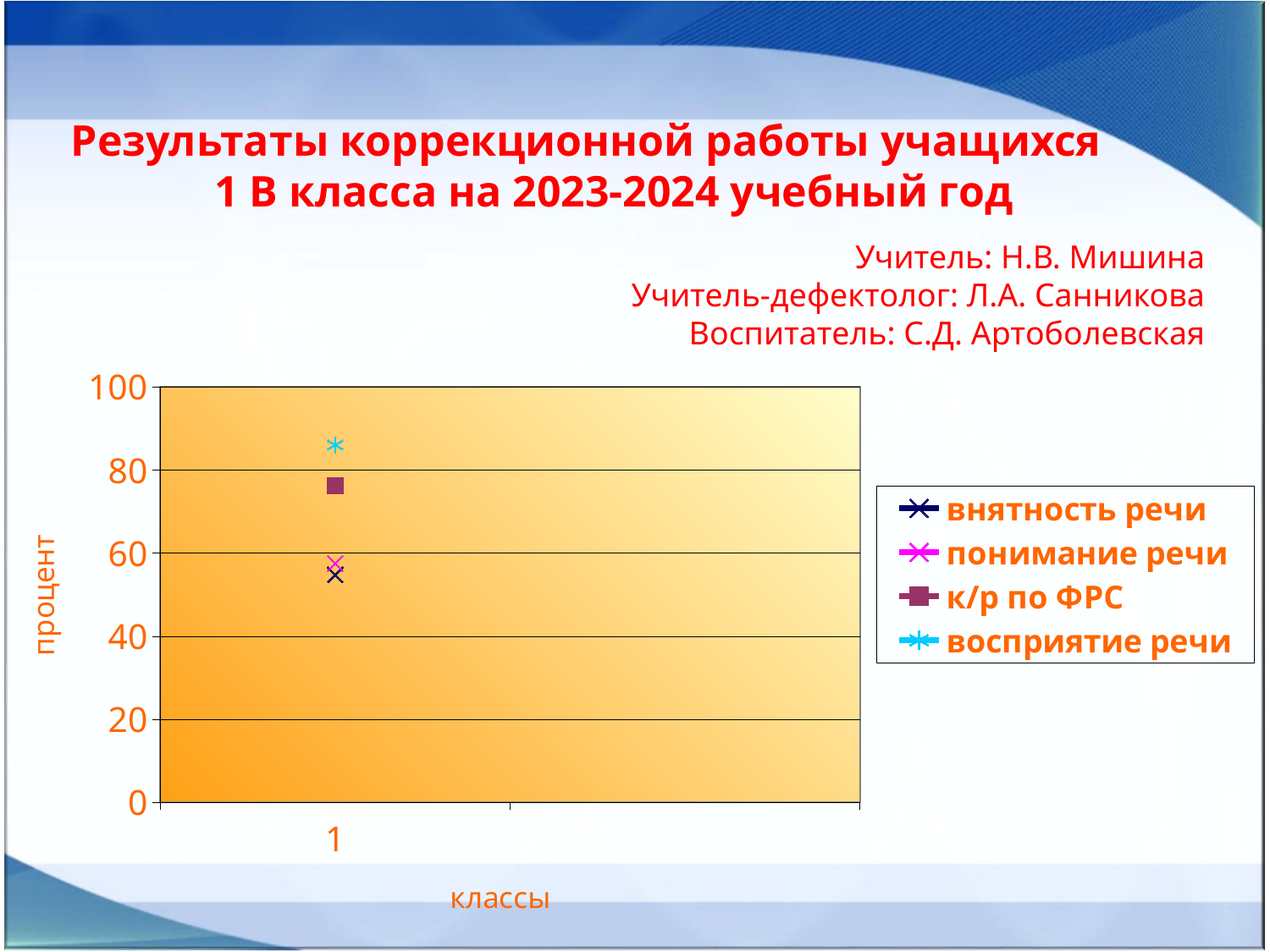
Is the value for к/р по ФРС greater or less than 80? less What is the title of the vertical axis? процент Is the value for внятность речи greater or less than 40? greater Which series has the highest value? восприятие речи How many categories are shown on the x axis? 1 Is the value for внятность речи greater or less than 60? less What is the title of the horizontal axis? классы How many series does the legend list? 4 What kind of chart is shown on the slide? line chart Which is larger, the value for восприятие речи or the value for к/р по ФРС? восприятие речи